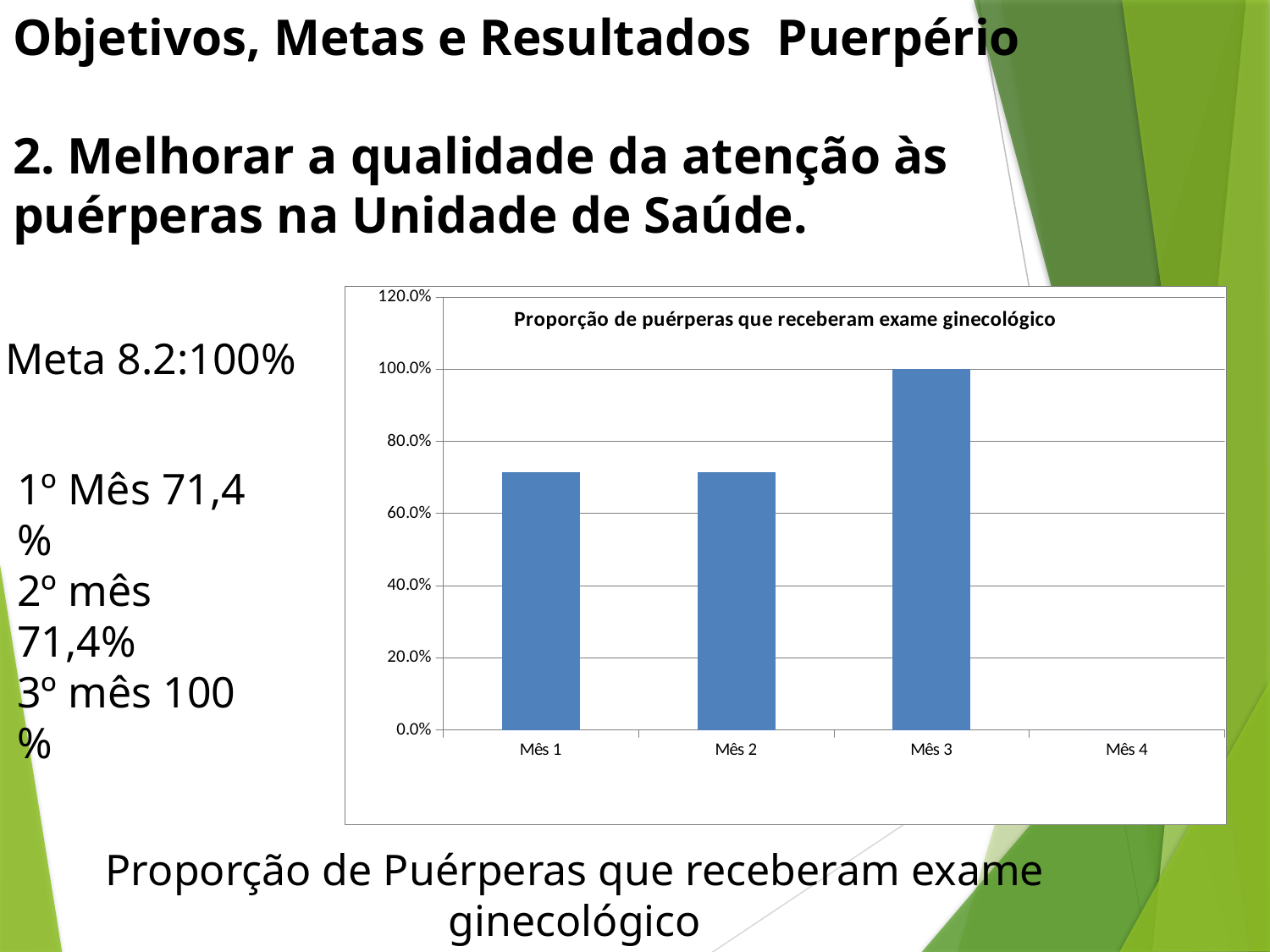
Is the value for Mês 1 greater or less than 60.0%? greater What is the value for Mês 3 in the chart? 100.0% Which is larger, the value for Mês 1 or the value for Mês 3? Mês 3 Which month category has no bar plotted in the chart? Mês 4 Which month has the highest bar in the chart? Mês 3 What kind of chart is shown on the slide? bar chart According to the slide text, what is the proportion for the 1º Mês? 71,4% What is the title of the chart? Proporção de puérperas que receberam exame ginecológico What is the highest value shown on the chart's vertical axis? 120.0% Do the bar values rise or fall from Mês 2 to Mês 3? rise Is the value for Mês 2 greater or less than 80.0%? less How many month categories are shown on the x axis of the chart? 4